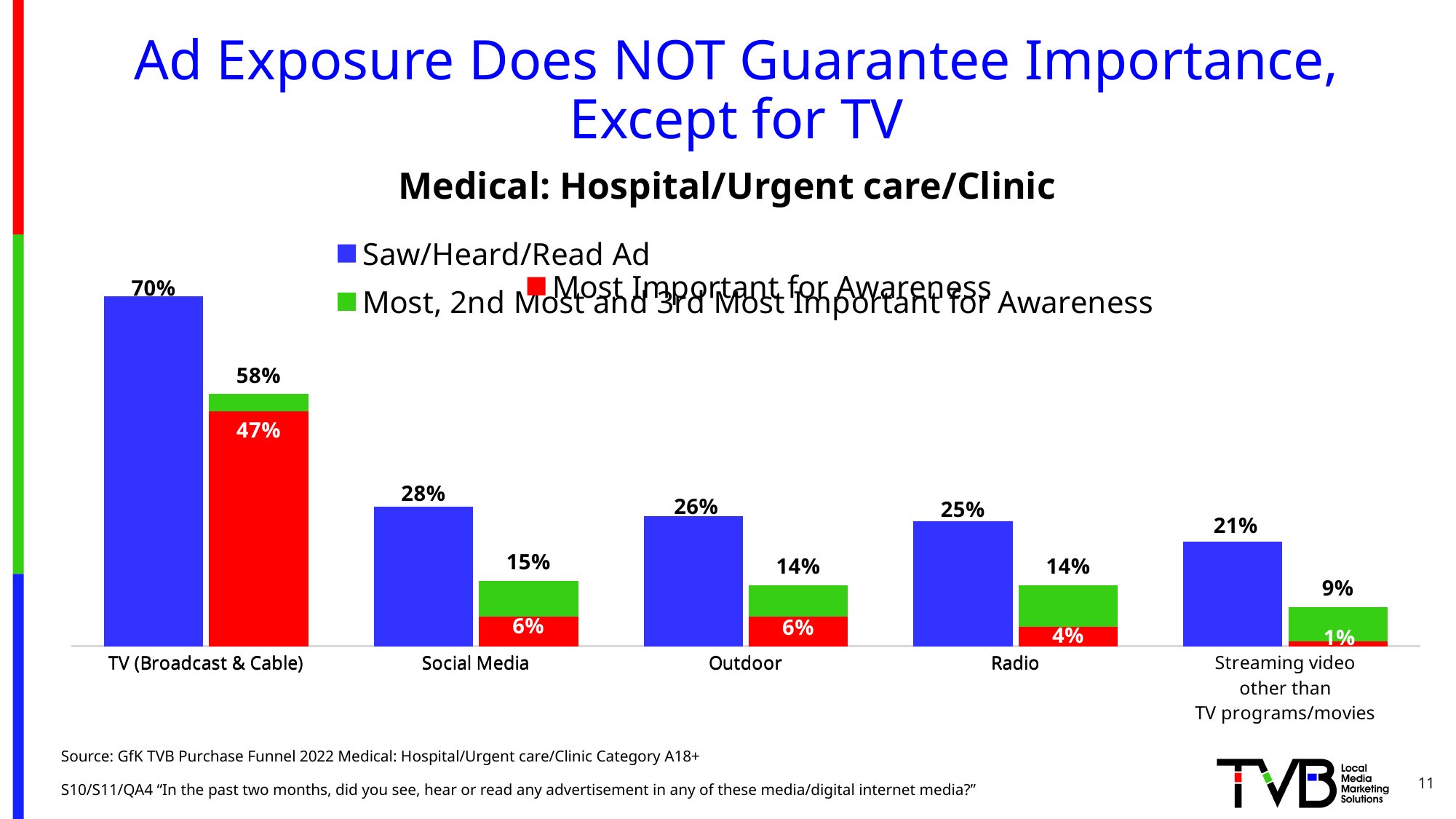
What is the difference between the Saw/Heard/Read Ad value and the Most Important for Awareness value for TV (Broadcast & Cable)? 23% Which category has the highest Saw/Heard/Read Ad value? TV (Broadcast & Cable) How many media categories are shown on the x axis? 5 Which is larger for Outdoor: the Saw/Heard/Read Ad value or the Most Important for Awareness value? Saw/Heard/Read Ad What is the Saw/Heard/Read Ad value for Radio? 25% What is the total of the stacked bar (Most, 2nd Most and 3rd Most Important for Awareness) for Radio? 14% How many series does the legend list? 3 What percentage of respondents Saw/Heard/Read an ad for TV (Broadcast & Cable)? 70% What is the Most Important for Awareness value for Social Media? 6% What is the Most Important for Awareness value for Streaming video other than TV programs/movies? 1% Which category has the lowest Saw/Heard/Read Ad value? Streaming video other than TV programs/movies What type of chart is shown on the slide? Bar chart